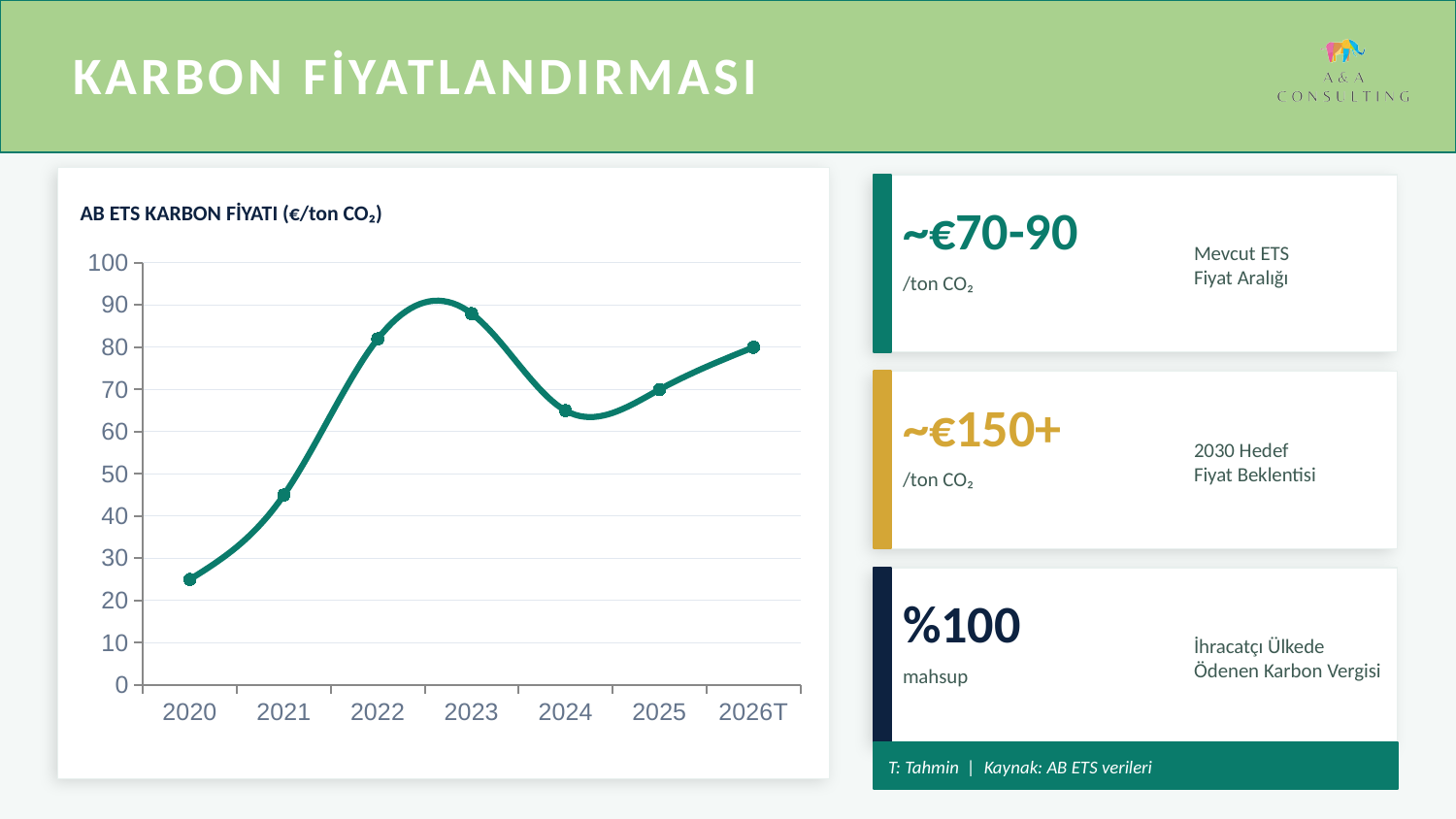
In which year does the AB ETS carbon price reach its highest point? 2023 In which year is the AB ETS carbon price lowest? 2020 What is the maximum value shown on the chart's y axis? 100 Does the carbon price rise or fall from 2020 to 2023? rise What is the title of the chart? AB ETS KARBON FİYATI (€/ton CO₂) How many years are plotted on the x axis of the chart? 7 What kind of chart is shown on the slide? line chart Is the value for 2020 greater or less than 30? less Which year has the higher carbon price, 2022 or 2024? 2022 Is the value for 2024 greater or less than 60? greater Is the value for 2021 greater or less than 50? less